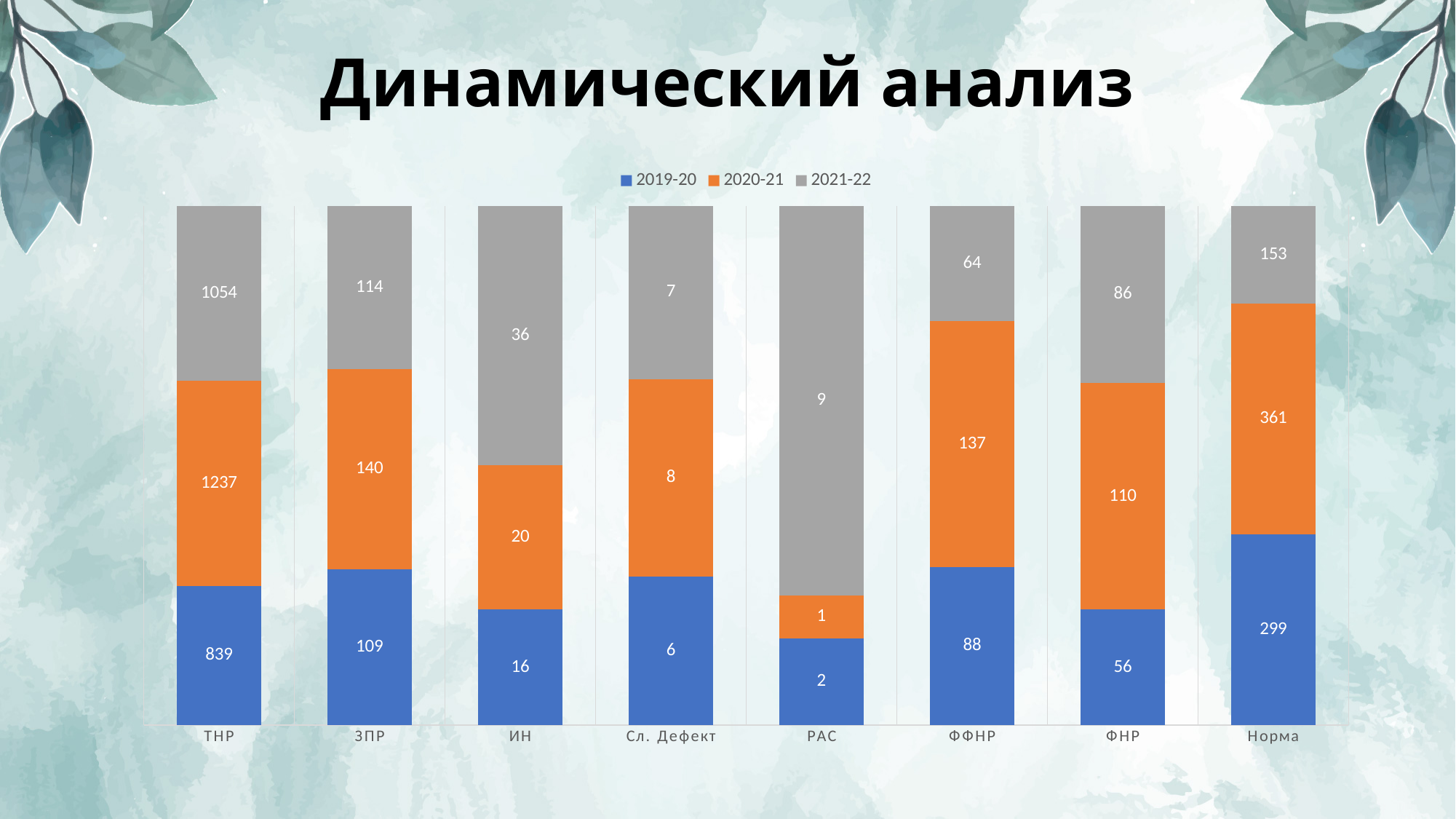
Which is larger for ФНР: the 2020-21 value or the 2021-22 value? 2020-21 What is the value for Норма in the 2019-20 series? 299 What is the title of the slide? Динамический анализ What is the difference between the 2020-21 and 2019-20 values for ФФНР? 49 What is the total of the stacked bar for ЗПР? 363 How many categories are shown on the x axis? 8 What is the value for РАС in the 2021-22 series? 9 What kind of chart is shown on the slide? Stacked bar chart Which category has the highest value in the 2021-22 series? ТНР Which category has the lowest value in the 2020-21 series? РАС What is the value for ТНР in the 2020-21 series? 1237 How many series does the legend list? 3